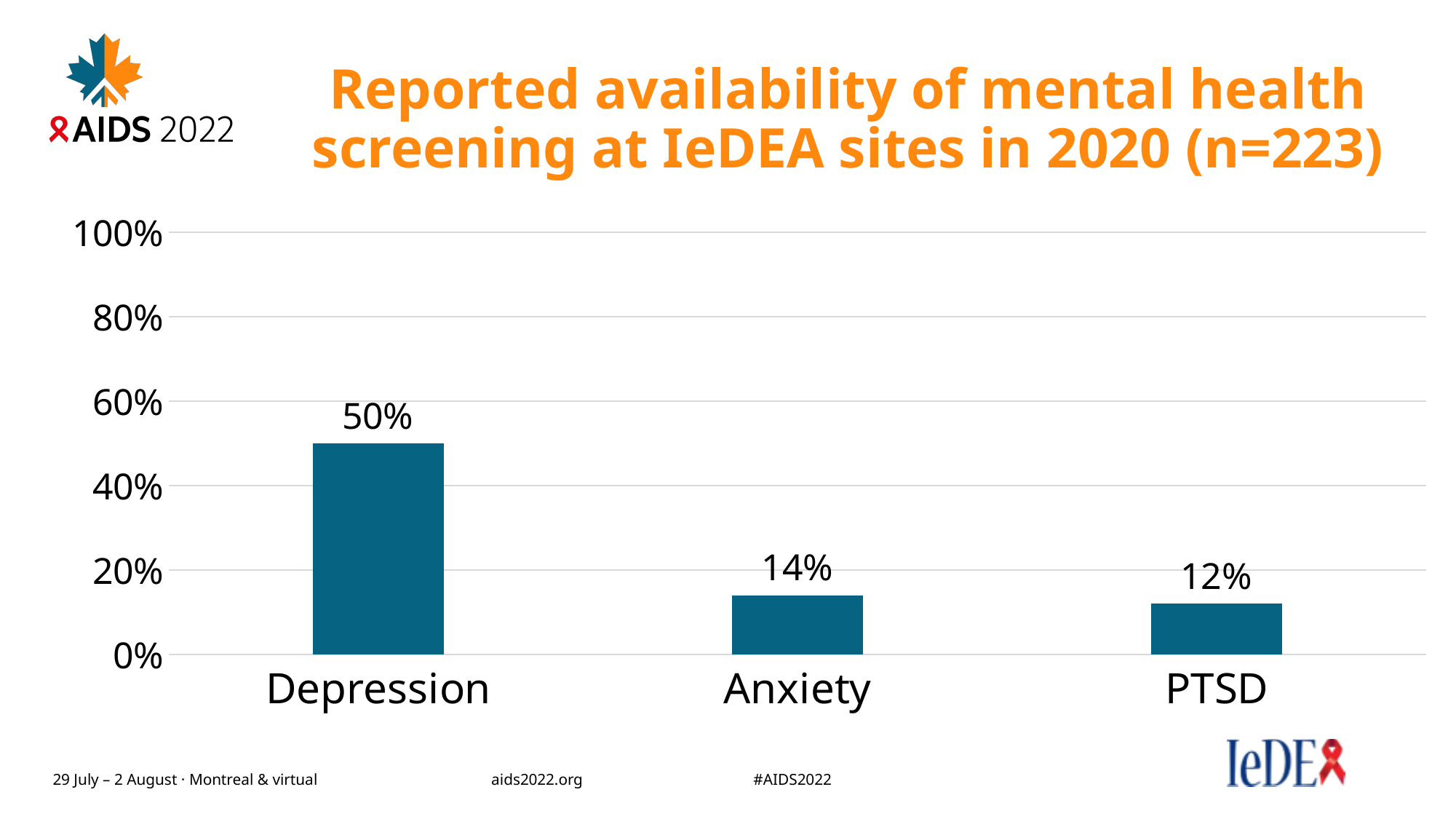
How many categories are shown in the chart? 3 What type of chart is shown on the slide? Bar chart Which category has the highest reported availability of screening? Depression Which category has the lowest reported availability of screening? PTSD What is the difference in percentage points between Depression and Anxiety screening availability? 36% What is the title of the chart? Reported availability of mental health screening at IeDEA sites in 2020 (n=223) Which has a higher reported availability, Depression or PTSD? Depression What is the reported availability of mental health screening for Anxiety? 14% What is the difference in percentage points between Anxiety and PTSD screening availability? 2% What is the reported availability of mental health screening for Depression? 50% Is the value for Anxiety greater or less than 20%? less What is the reported availability of mental health screening for PTSD? 12%